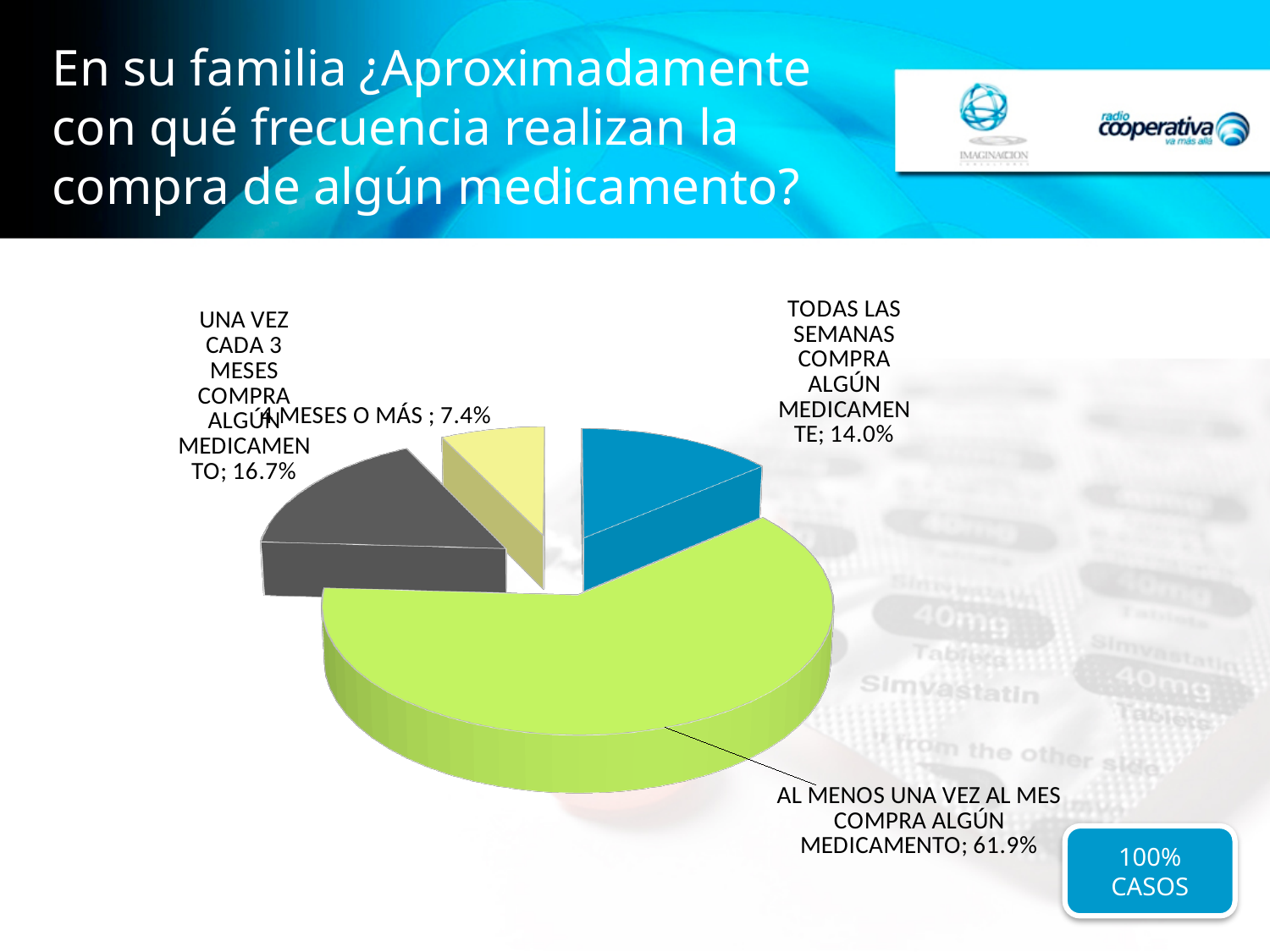
What kind of chart is shown on the slide? pie chart How many slices does the pie chart have? 4 What percentage corresponds to the category '4 MESES O MÁS'? 7.4% What colour is the slice for 'AL MENOS UNA VEZ AL MES COMPRA ALGÚN MEDICAMENTO'? green What percentage of families buy some medication at least once a month (AL MENOS UNA VEZ AL MES)? 61.9% What is the difference in percentage points between 'TODAS LAS SEMANAS' (14.0%) and '4 MESES O MÁS' (7.4%)? 6.6 Which category has the largest share of the pie? AL MENOS UNA VEZ AL MES COMPRA ALGÚN MEDICAMENTO What percentage of families buy some medication once every 3 months (UNA VEZ CADA 3 MESES)? 16.7% What is the difference in percentage points between 'AL MENOS UNA VEZ AL MES' (61.9%) and 'UNA VEZ CADA 3 MESES' (16.7%)? 45.2 Which category has the smallest share of the pie? 4 MESES O MÁS Which is larger: the share for 'TODAS LAS SEMANAS' or the share for 'UNA VEZ CADA 3 MESES'? UNA VEZ CADA 3 MESES What percentage of families buy some medication every week (TODAS LAS SEMANAS)? 14.0%